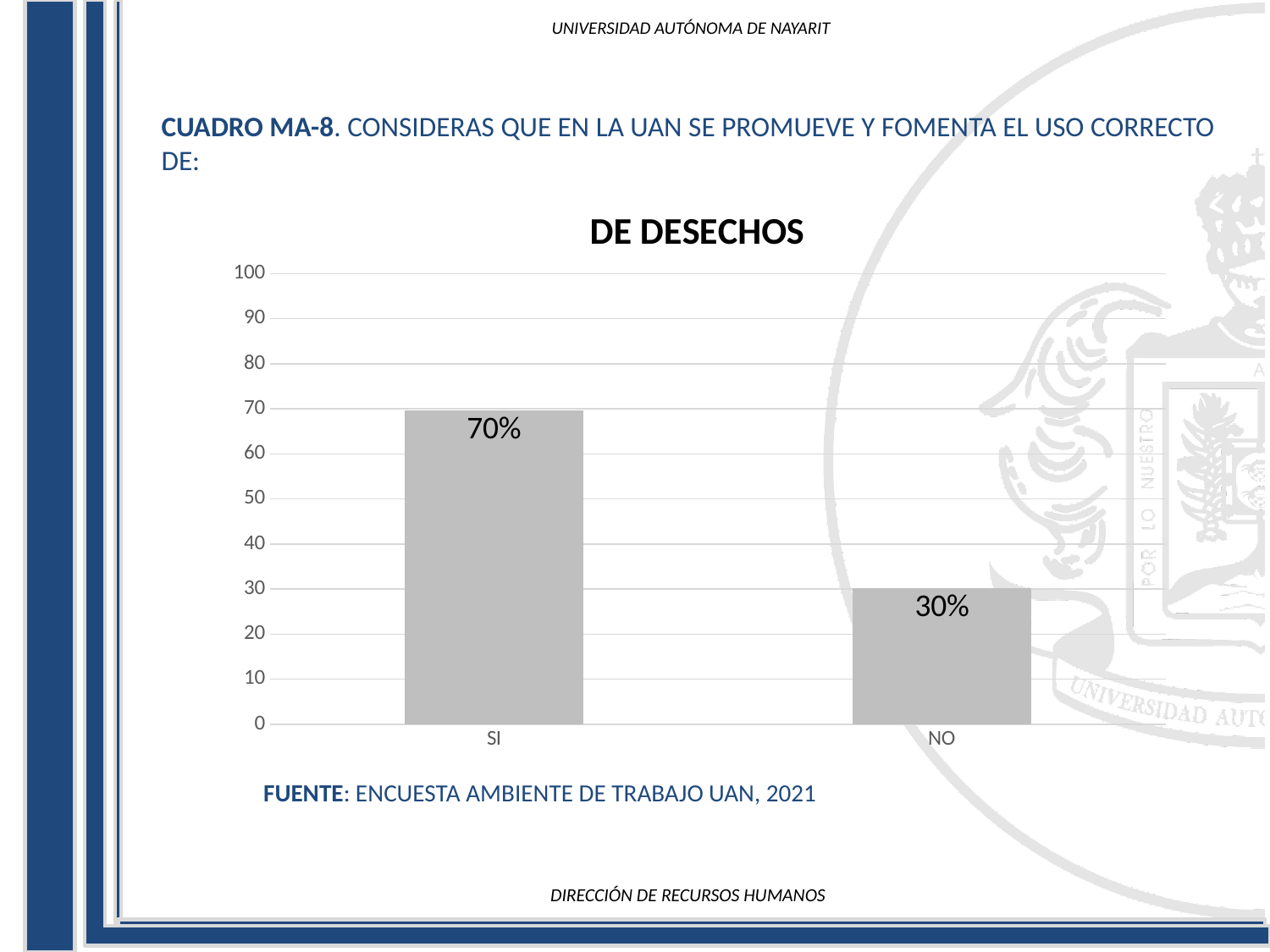
What is the maximum value shown on the y axis? 100 What is the title of the chart? DE DESECHOS What is the value for SI? 70% Is the value for SI greater or less than 50? greater Which category has the highest value? SI Which is larger, the value for SI or the value for NO? SI What is the difference between the values for SI and NO? 40% How many categories are shown on the x axis? 2 Which category has the lowest value? NO Is the value for NO greater or less than 40? less What kind of chart is shown? bar chart What is the value for NO? 30%